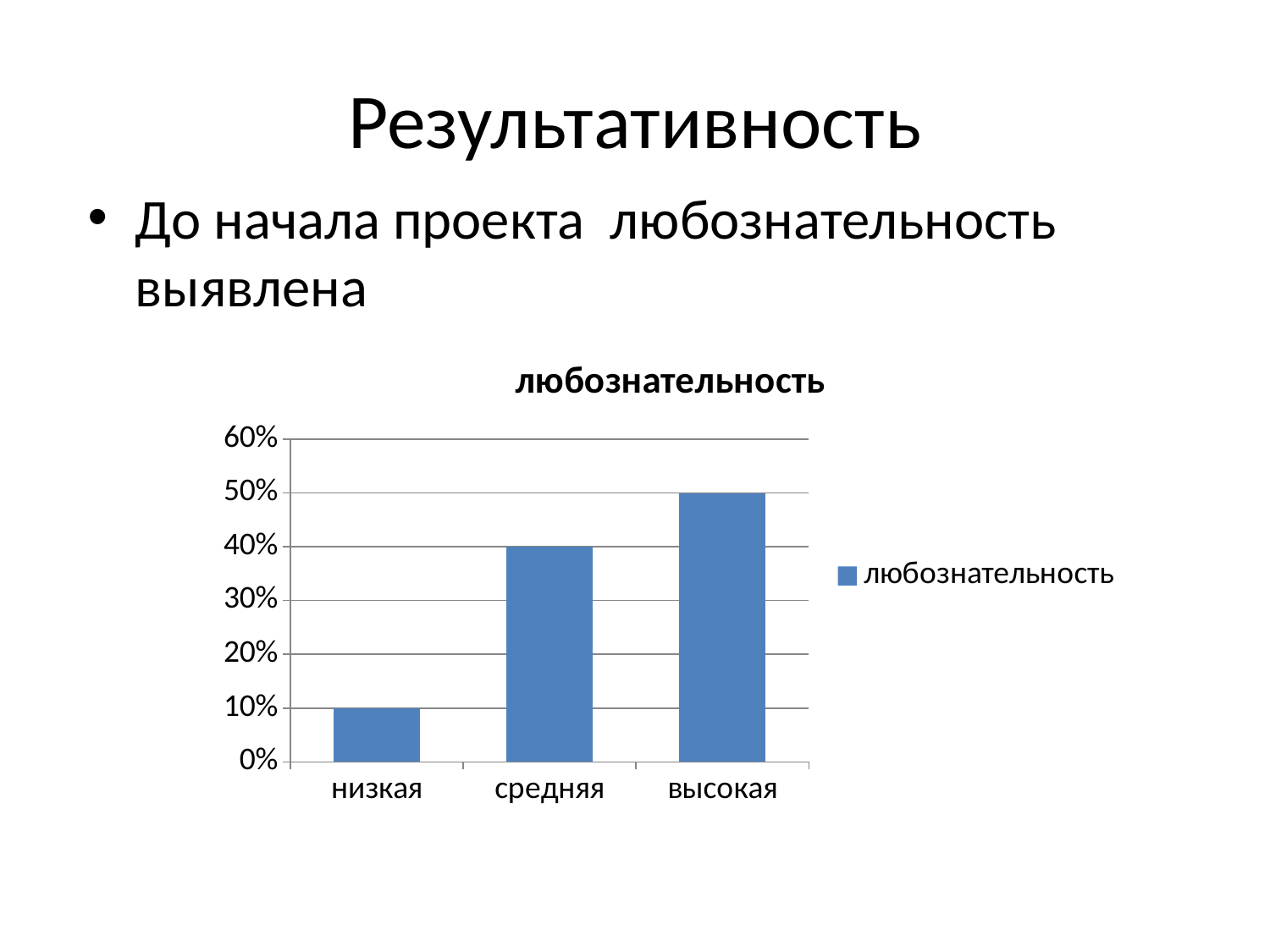
How many series does the legend list? 1 Do the values rise or fall from left to right along the x axis? rise Which is larger, the value for 'средняя' or the value for 'низкая'? средняя What is the title of the chart? любознательность Which category has the highest value? высокая What is the value for the category 'высокая'? 50% What is the value for the category 'низкая'? 10% Which category has the lowest value? низкая What type of chart is shown on the slide? bar chart What is the value for the category 'средняя'? 40% How many categories are shown on the x axis of the chart? 3 What is the difference between the values for 'высокая' and 'низкая'? 40%